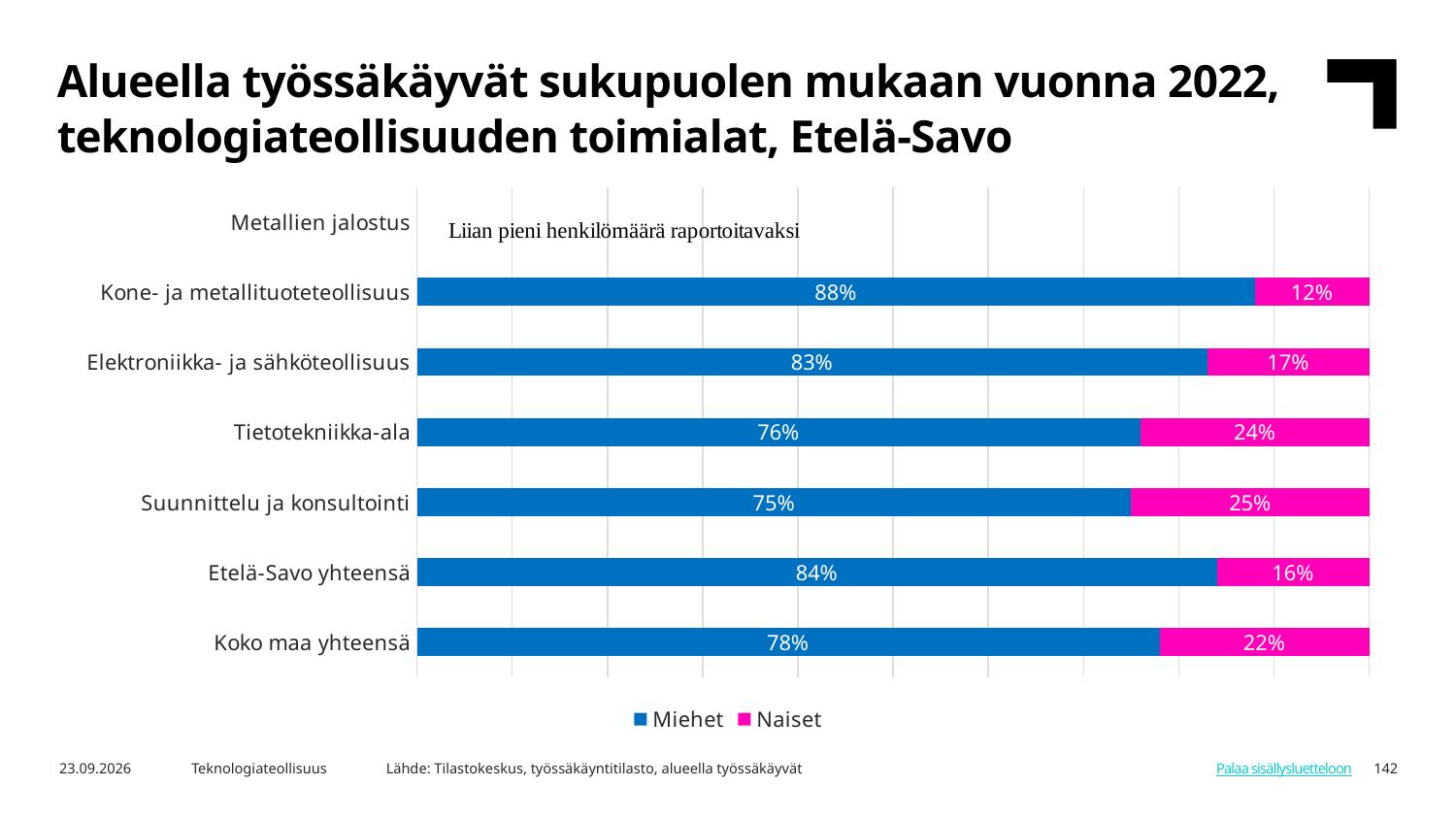
What kind of chart is shown on the slide? Stacked bar chart Which category has the highest Naiset share? Suunnittelu ja konsultointi How many series does the legend list? 2 What is the total of the stacked bar for Suunnittelu ja konsultointi? 100% What text is shown in place of a bar for Metallien jalostus? Liian pieni henkilömäärä raportoitavaksi What is the Miehet share for Koko maa yhteensä? 78% Which category has the lowest Naiset share? Kone- ja metallituoteteollisuus Which is larger: the Naiset share for Koko maa yhteensä or for Etelä-Savo yhteensä? Koko maa yhteensä What is the Naiset share for Etelä-Savo yhteensä? 16% What is the difference between the Miehet share for Elektroniikka- ja sähköteollisuus and for Tietotekniikka-ala? 7 percentage points What is the Miehet share for Kone- ja metallituoteteollisuus? 88% What is the Naiset share for Tietotekniikka-ala? 24%